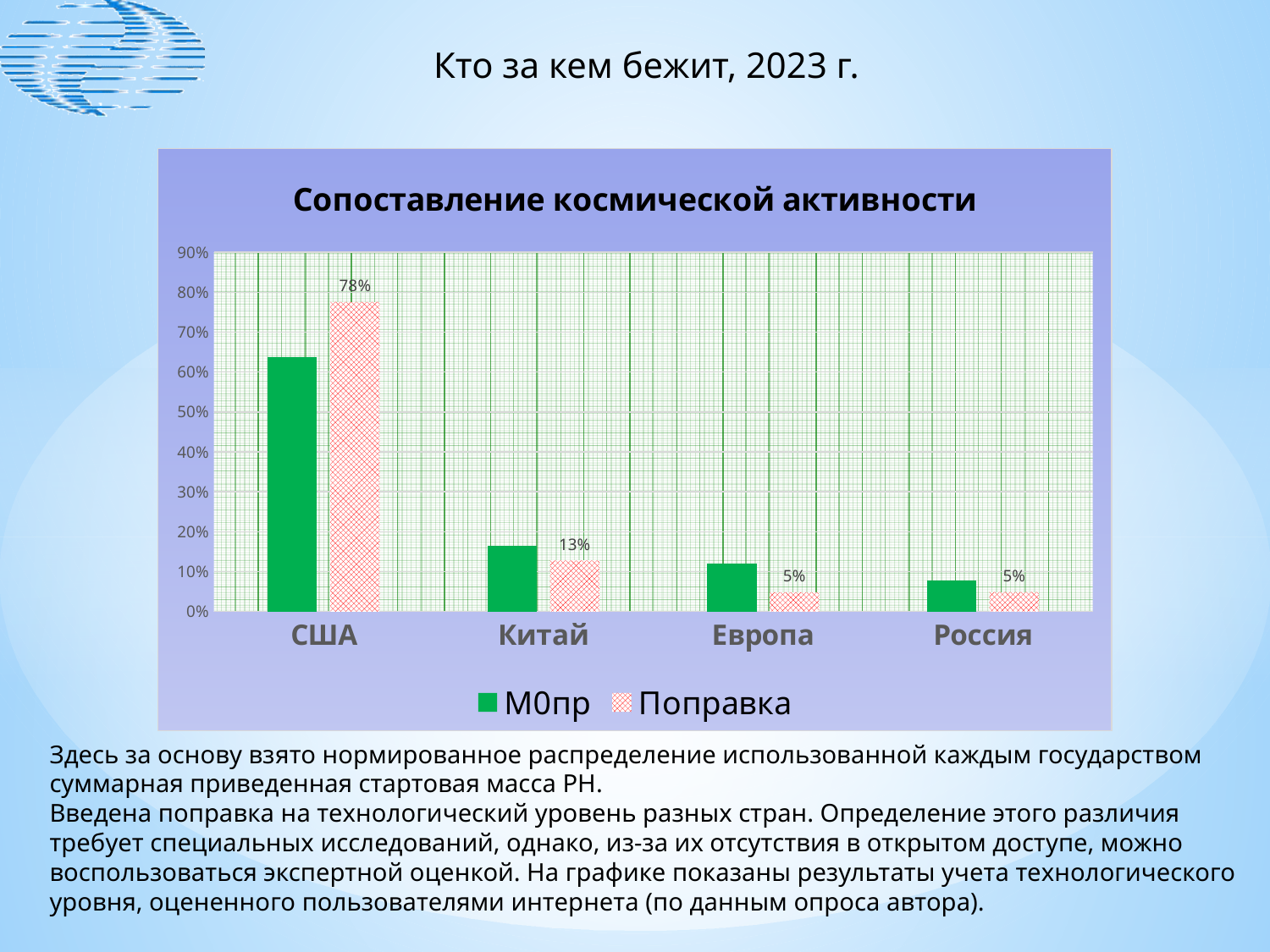
Is the М0пр value for Китай greater or less than 20%? less Is the М0пр value for Россия greater or less than 10%? less What is the value of Поправка for Европа? 5% What is the difference between the Поправка values for США and Китай? 65% What is the value of Поправка for Китай? 13% Which is larger, the Поправка value for Китай or for Россия? Китай How many categories are shown on the x axis? 4 Which category has the highest Поправка value? США Is the М0пр value for США greater or less than 60%? greater How many series does the legend list? 2 What kind of chart is shown on the slide? bar chart What is the value of Поправка for США? 78%